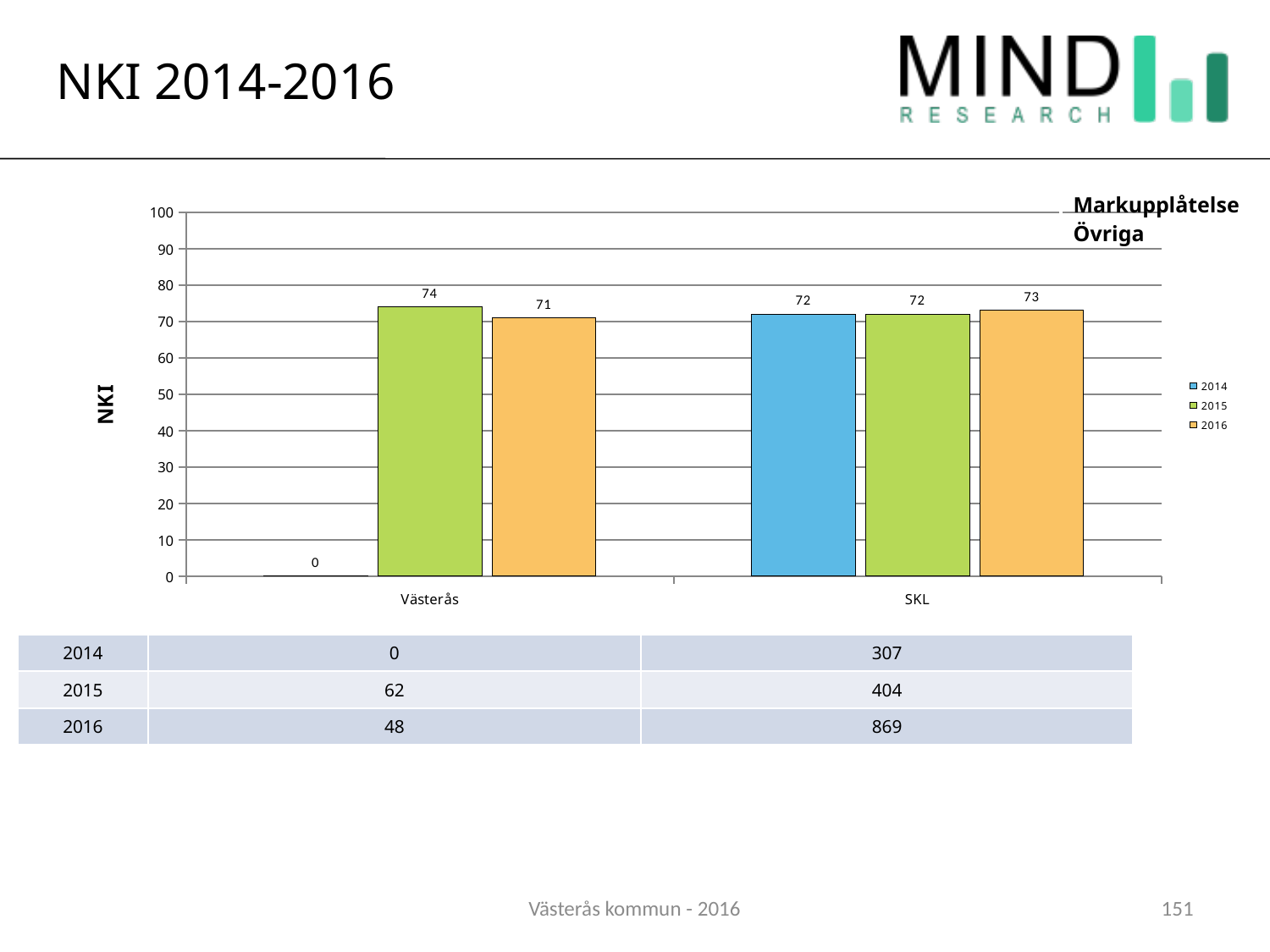
What is the NKI value for Västerås in 2014? 0 What is the NKI value for SKL in 2014? 72 What is the NKI value for Västerås in 2015? 74 What is the NKI value for SKL in 2016? 73 Which year has the lowest NKI value for SKL? 2014 and 2015 (both 72) What is the NKI value for Västerås in 2016? 71 What is the label on the vertical axis of the chart? NKI Which is larger, the 2016 NKI value for Västerås or for SKL? SKL What kind of chart is shown on the slide? Bar chart How many series does the legend list? 3 What is the difference between the Västerås NKI values for 2015 and 2016? 3 Which year has the highest NKI value for Västerås? 2015